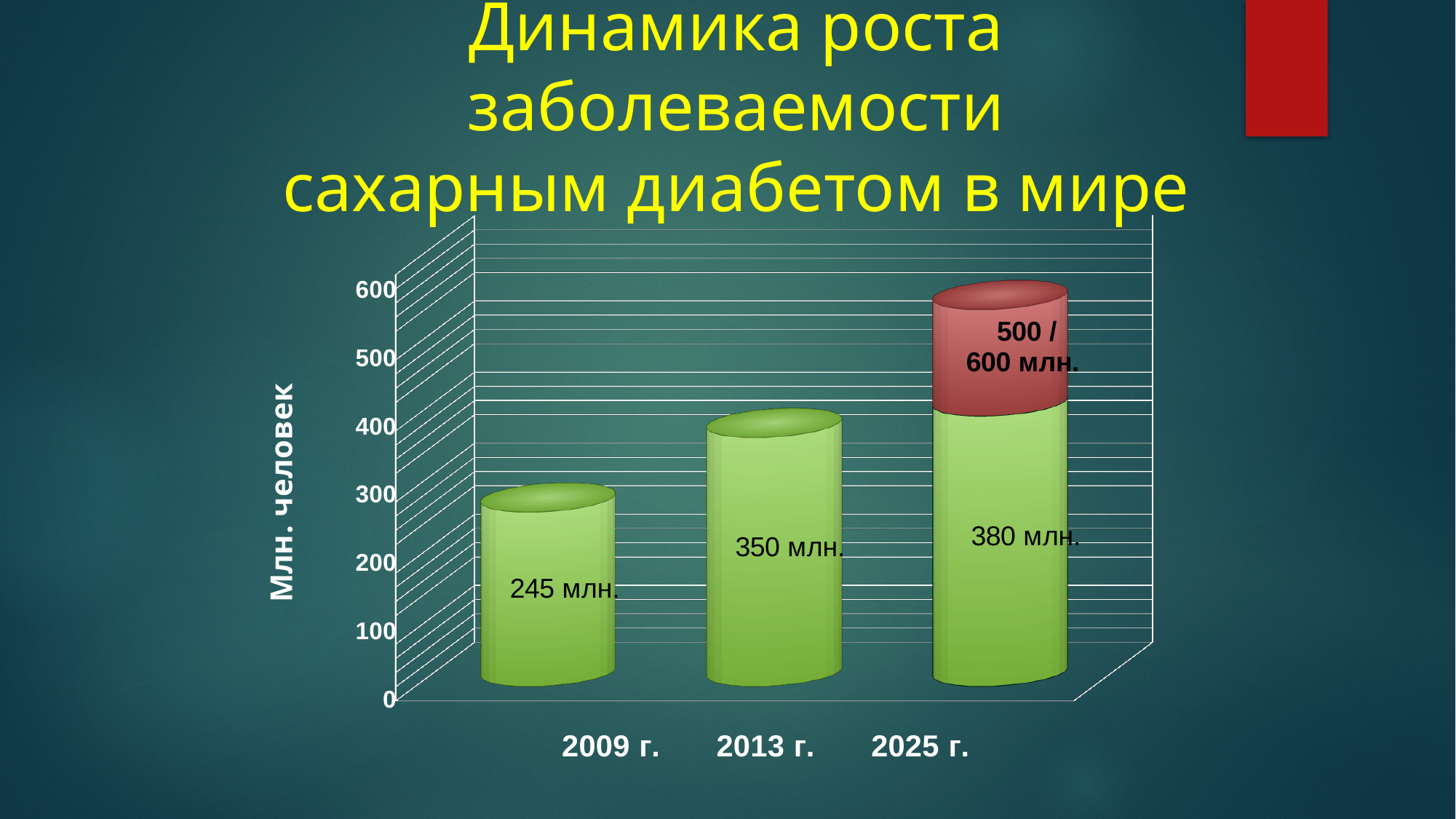
What is the difference between the green value for 2025 г. and the value for 2013 г.? 30 млн. How many years are shown on the x axis? 3 Which year has the tallest bar? 2025 г. What value is printed on the green part of the bar for 2025 г.? 380 млн. What is the value shown for 2009 г.? 245 млн. What is the value shown for 2013 г.? 350 млн. Which year has the lowest value? 2009 г. Is the value for 2009 г. greater or less than 300? less By how much does the value for 2013 г. exceed the value for 2009 г.? 105 млн. Which is larger, the value for 2009 г. or the value for 2013 г.? 2013 г. What type of chart is shown on the slide? bar chart What label is printed on the red top segment of the 2025 г. bar? 500 / 600 млн.